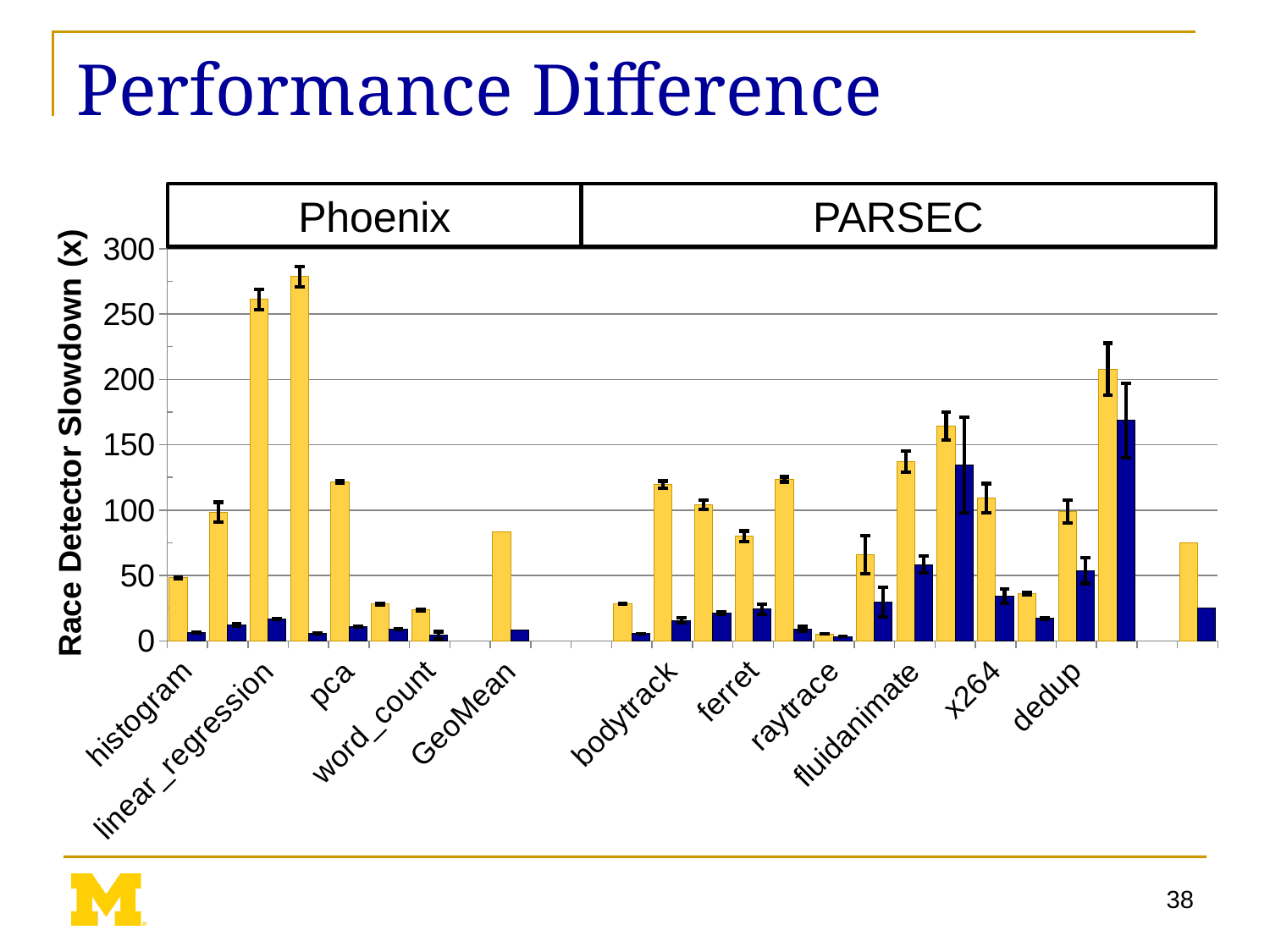
Is the yellow bar for word_count greater or less than 50? less Is the yellow bar for fluidanimate greater or less than 50? greater Is the yellow bar for histogram greater or less than 100? less What type of chart is shown on the slide? bar chart What are the two benchmark suite groups labelled above the chart? Phoenix and PARSEC Which has the taller yellow bar, linear_regression or pca? linear_regression Which has the taller yellow bar, word_count or pca? pca What is the label of the vertical axis? Race Detector Slowdown (x) For histogram, which bar is taller, the yellow bar or the blue bar? the yellow bar